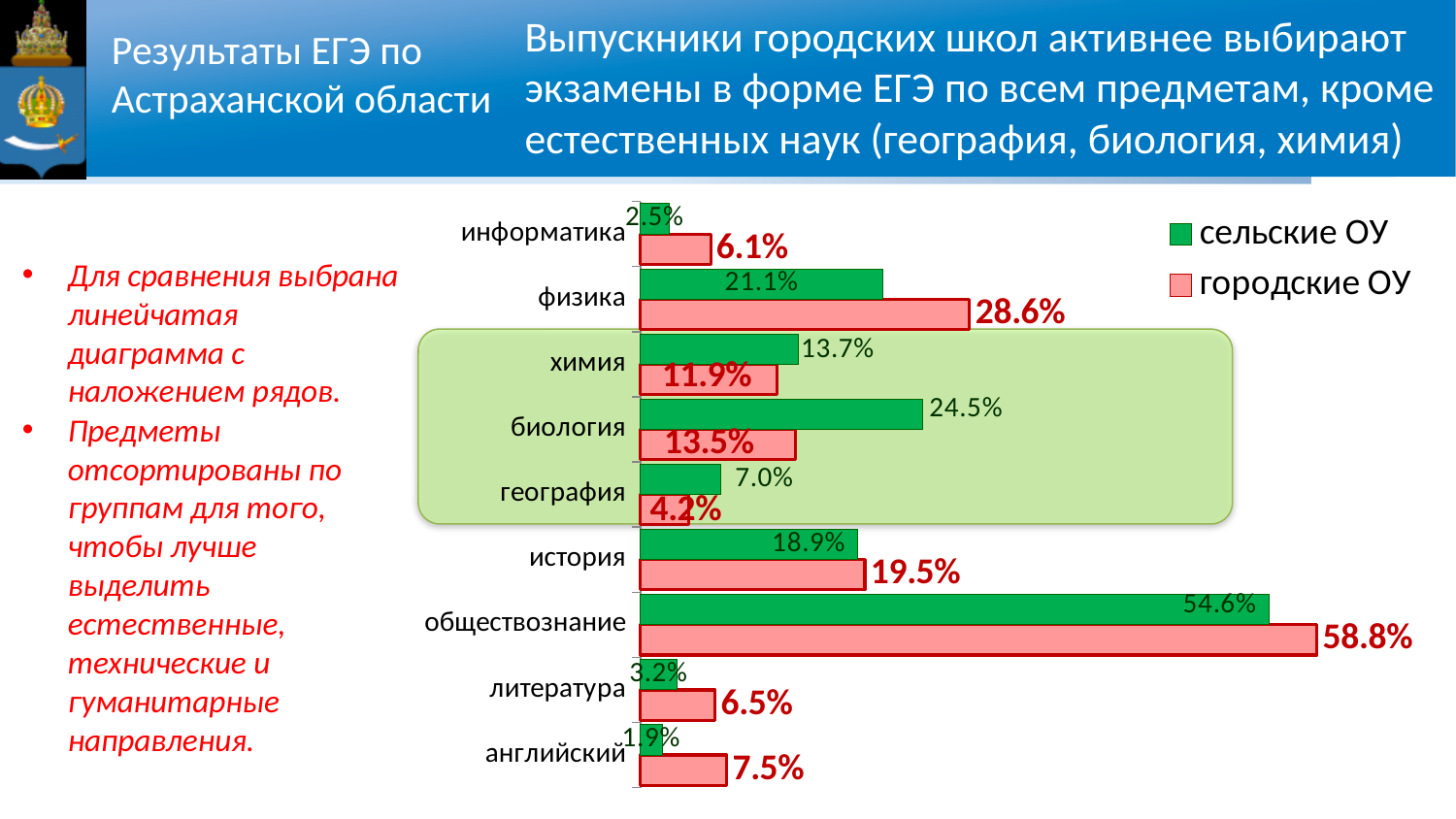
How many subjects (categories) are shown in the chart? 9 Which colour represents городские ОУ in the chart? pink For химия, which series has the larger value, сельские ОУ or городские ОУ? сельские ОУ What is the value for сельские ОУ for английский? 1.9% Which subject has the lowest value for городские ОУ? география Which subject has the highest value for сельские ОУ? обществознание What type of chart is shown on the slide? bar chart What is the value for городские ОУ for обществознание? 58.8% What is the value for городские ОУ for физика? 28.6% What is the value for сельские ОУ for биология? 24.5% How many series does the legend list? 2 What is the difference between городские ОУ and сельские ОУ for физика? 7.5%